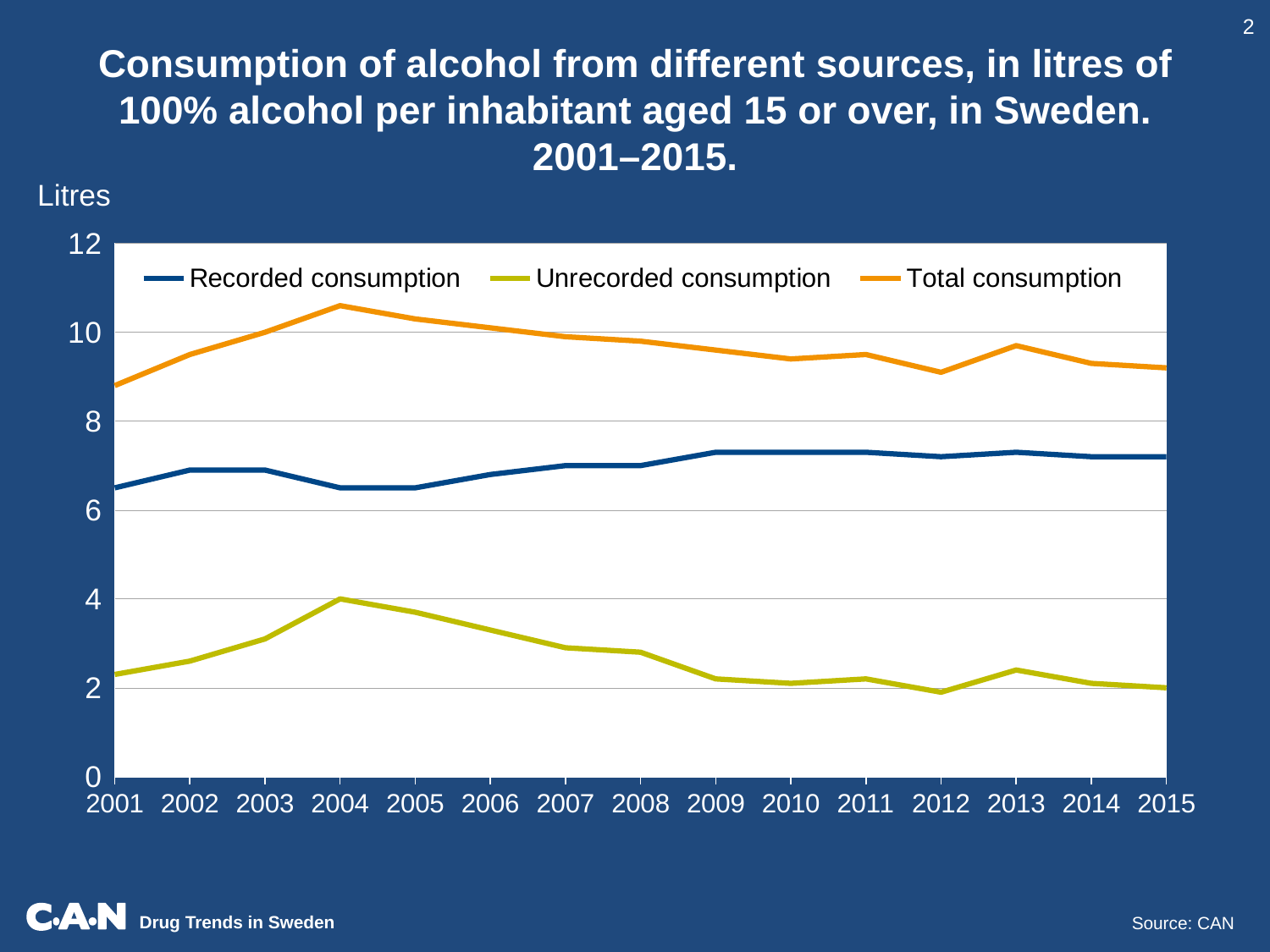
Is the value for Recorded consumption in 2009 greater or less than 6? greater Does Unrecorded consumption rise or fall between 2004 and 2009? Fall In which year does Unrecorded consumption reach its highest value? 2004 In which year does Total consumption reach its highest value? 2004 Which is larger in 2010, Recorded consumption or Unrecorded consumption? Recorded consumption In which year is Total consumption at its lowest? 2001 Is the value for Unrecorded consumption in 2007 greater or less than 2? greater Is the value for Total consumption in 2001 greater or less than 10? less How many series does the legend list? 3 What kind of chart is shown on the slide? Line chart Which colour is used for the Total consumption line? Orange How many years are plotted along the x axis? 15